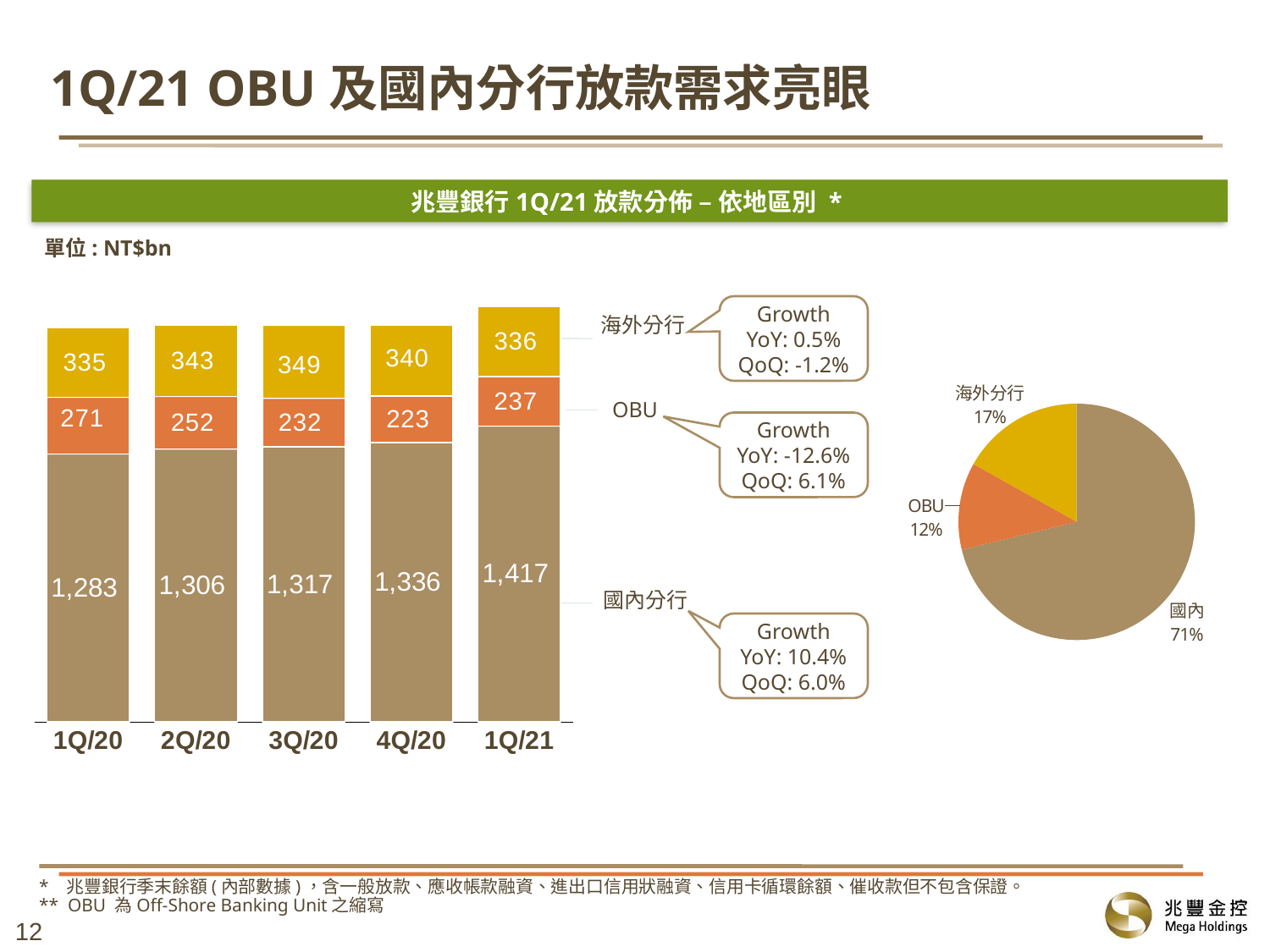
In the stacked bar chart, which quarter has the highest 國內分行 value? 1Q/21 In the stacked bar chart, what is the total of the 1Q/21 bar? 1,990 In the stacked bar chart, what is the 海外分行 value for 2Q/20? 343 In the stacked bar chart, what is the difference between the 國內分行 values for 1Q/21 and 4Q/20? 81 In the stacked bar chart, is the OBU value for 1Q/20 larger or smaller than the OBU value for 1Q/21? larger In the pie chart, what share does 海外分行 have? 17% In the stacked bar chart, which quarter has the lowest OBU value? 4Q/20 In the stacked bar chart, what is the OBU value for 3Q/20? 232 What kind of chart is shown on the right side of the slide? pie chart In the stacked bar chart, do the 國內分行 values rise or fall from 1Q/20 to 1Q/21? rise How many quarters are shown on the x axis of the stacked bar chart? 5 In the stacked bar chart, what is the value for 國內分行 in 1Q/21? 1,417